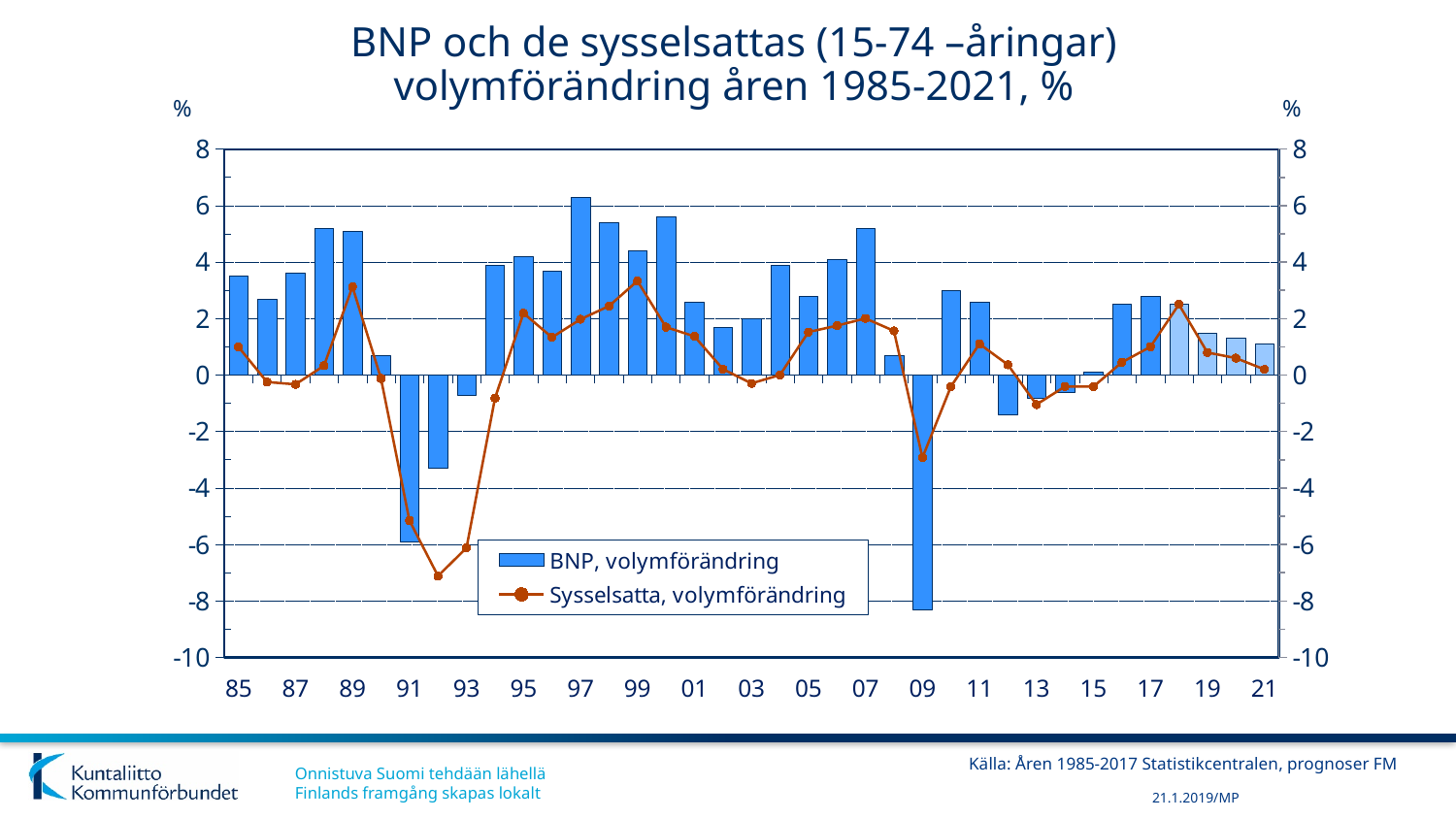
Do the BNP, volymförändring bars rise or fall from 2018 to 2021? fall How many series does the legend list? 2 In which year is the BNP, volymförändring bar lowest? 2009 In which year does the Sysselsatta, volymförändring line reach its lowest point? 1992 Which year has the larger Sysselsatta, volymförändring value, 1989 or 1990? 1989 What kind of chart is shown on the slide? A combined bar and line chart Is the BNP, volymförändring value for 2009 greater or less than -6? less Which year has the larger BNP, volymförändring value, 1988 or 1990? 1988 In which year is the BNP, volymförändring bar highest? 1997 Is the Sysselsatta, volymförändring value for 1991 greater or less than -4? less What are the two series named in the legend? BNP, volymförändring and Sysselsatta, volymförändring Is the BNP, volymförändring value for 1997 greater or less than 4? greater